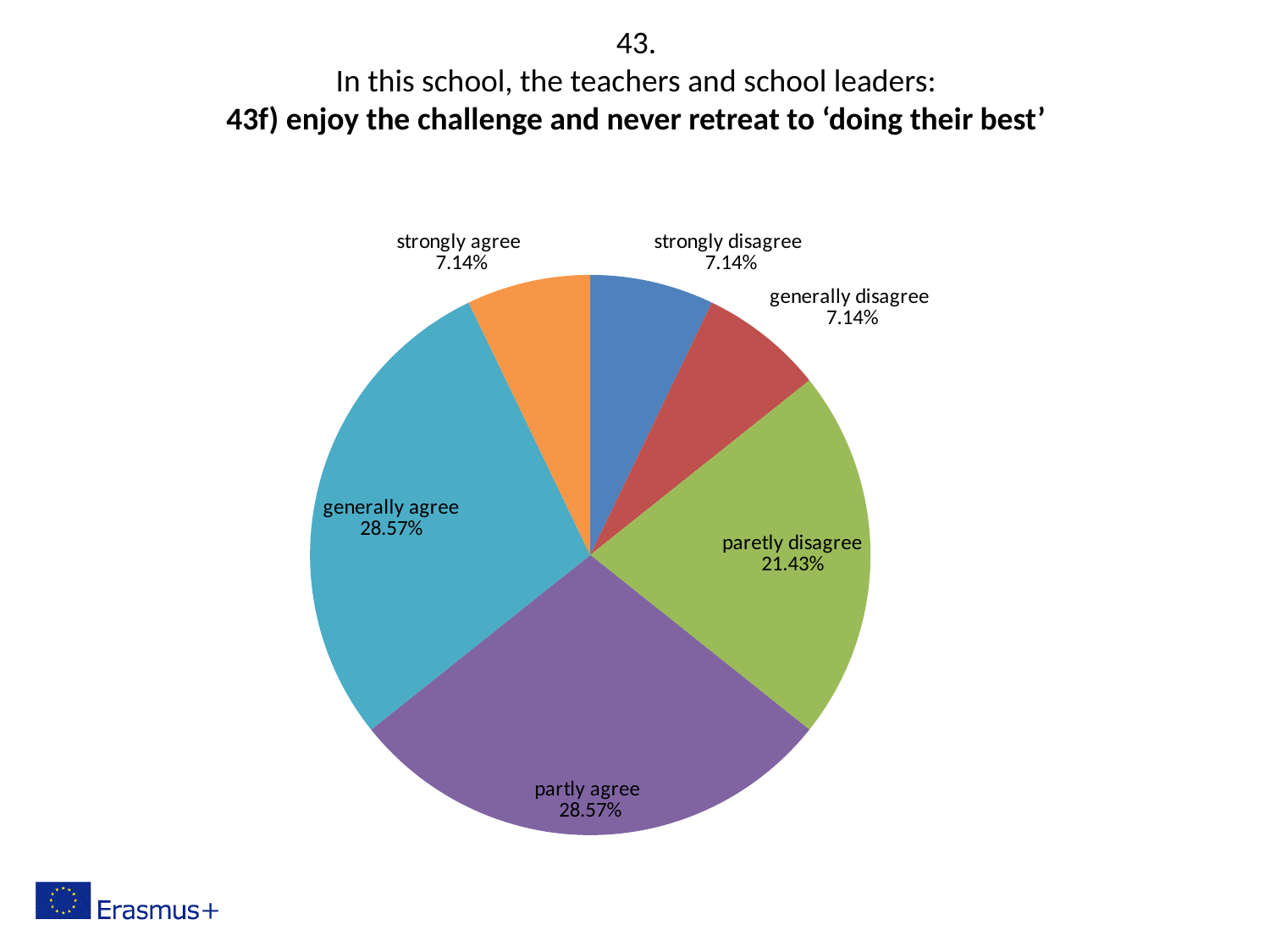
What is the combined share of the three 'agree' slices (strongly agree, generally agree, partly agree)? 64.28% Which slice is larger, 'partly disagree' or 'generally agree'? generally agree Which slice is larger, 'strongly disagree' or 'partly agree'? partly agree What share of the pie is 'generally agree'? 28.57% What is the difference between the 'partly agree' and 'partly disagree' shares? 7.14% How many slices does the pie chart have? 6 What percentage is shown for 'strongly agree'? 7.14% What percentage is shown for 'partly disagree'? 21.43% What share of the pie is 'partly agree'? 28.57% What is the difference between the 'generally agree' and 'strongly agree' shares? 21.43% What kind of chart is shown on the slide? pie chart What percentage is shown for 'generally disagree'? 7.14%